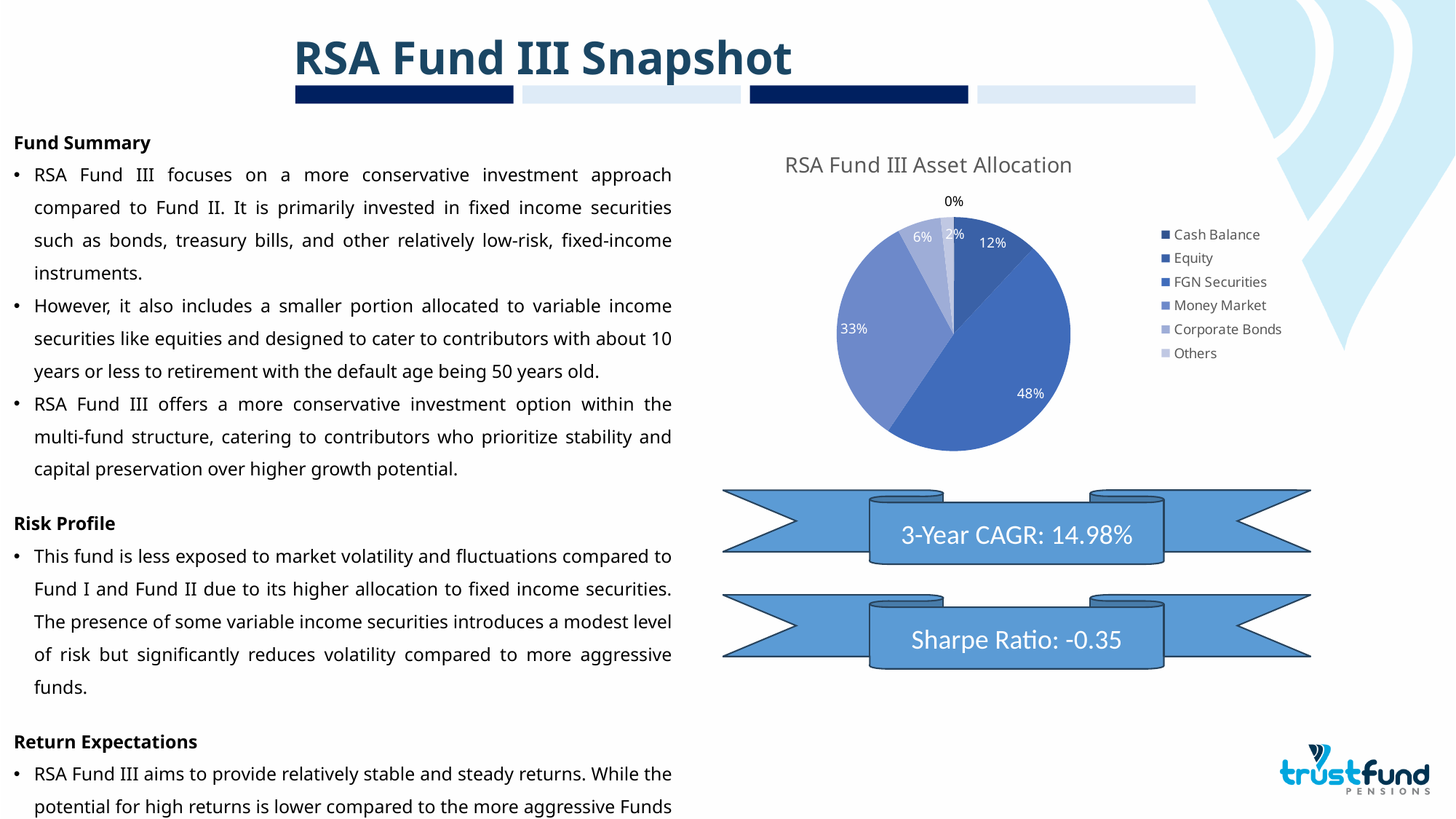
What is the title of the chart on the slide? RSA Fund III Asset Allocation What is the combined share of the slices labelled 12% and 48% in the pie chart? 60% What is the difference between the largest slice (48%) and the second-largest slice (33%) in the pie chart? 15% What kind of chart is shown on the slide? pie chart What share of the pie chart is allocated to Cash Balance? 0% What percentage is shown for the largest slice of the pie chart? 48% What is the smallest percentage labelled on the pie chart? 0% Which is larger in the pie chart, the slice labelled 33% or the slice labelled 6%? 33% How many categories does the legend of the pie chart list? 6 How many slices of the pie chart have a percentage label of 2% or less? 2 Which legend entry is listed first in the pie chart's legend? Cash Balance